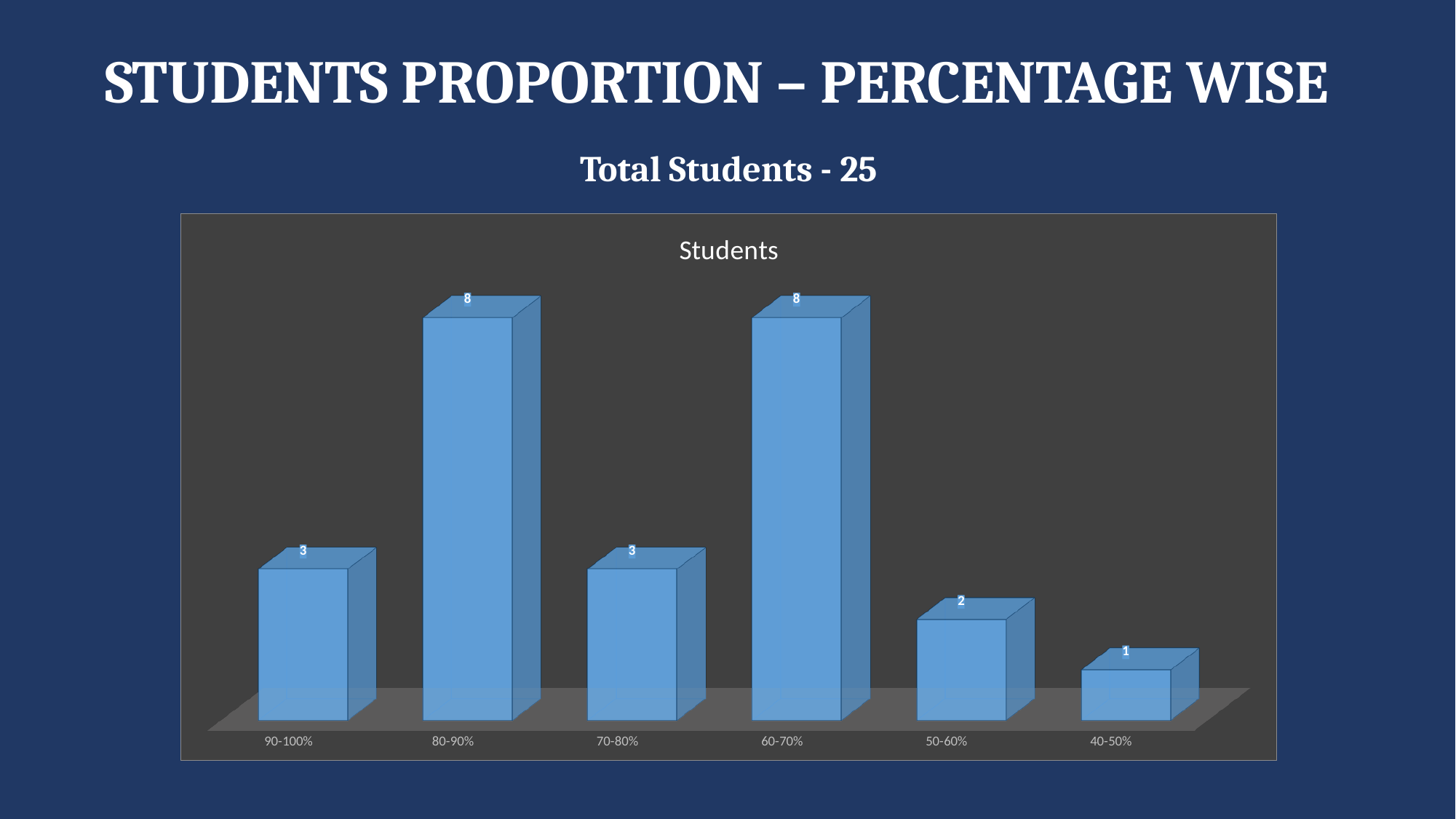
Which category has the lowest value? 40-50% How many students are in the 90-100% category? 3 How many categories are shown on the x axis? 6 What is the value for the 50-60% category? 2 Which is larger, the value for 90-100% or the value for 50-60%? 90-100% What kind of chart is shown on the slide? Bar chart What is the total number of students stated above the chart? 25 What is the difference between the values for 60-70% and 70-80%? 5 How many students are in the 80-90% category? 8 What is the title of the chart? Students What is the value for the 40-50% category? 1 What is the difference between the values for 50-60% and 40-50%? 1